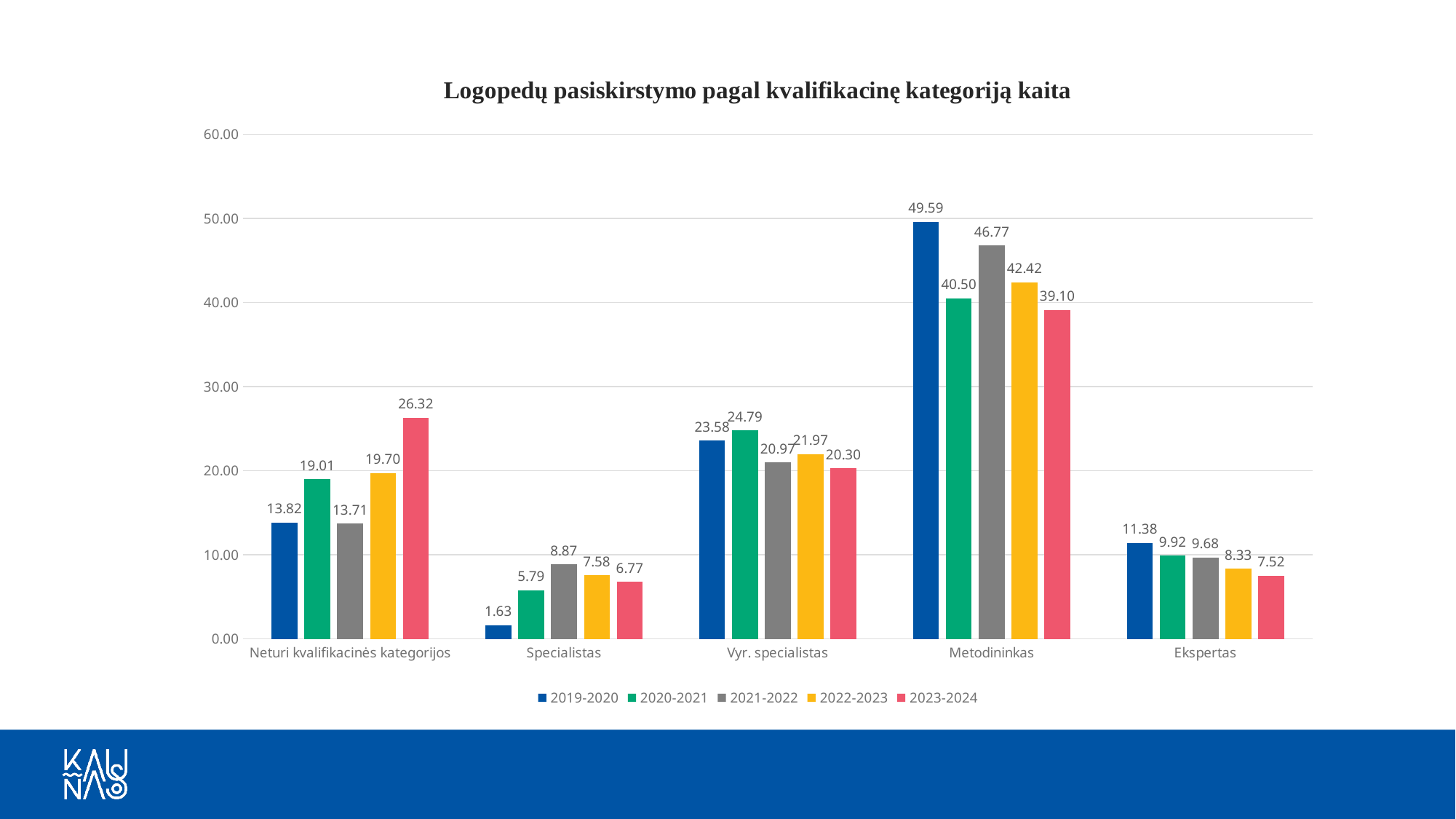
Which category has the lowest value in the 2019-2020 series? Specialistas What is the value for Neturi kvalifikacinės kategorijos in the 2022-2023 series? 19.70 Which category has the highest value in the 2021-2022 series? Metodininkas What is the difference between the 2019-2020 and 2023-2024 values for Metodininkas? 10.49 What is the value for Metodininkas in the 2019-2020 series? 49.59 What kind of chart is shown on the slide? bar chart Is the value for Metodininkas in 2020-2021 greater or less than 30.00? greater How many categories are shown on the x axis? 5 Which is larger for Ekspertas: the 2019-2020 value or the 2023-2024 value? 2019-2020 How many series does the legend list? 5 What is the title of the chart? Logopedų pasiskirstymo pagal kvalifikacinę kategoriją kaita What is the value for Specialistas in the 2023-2024 series? 6.77